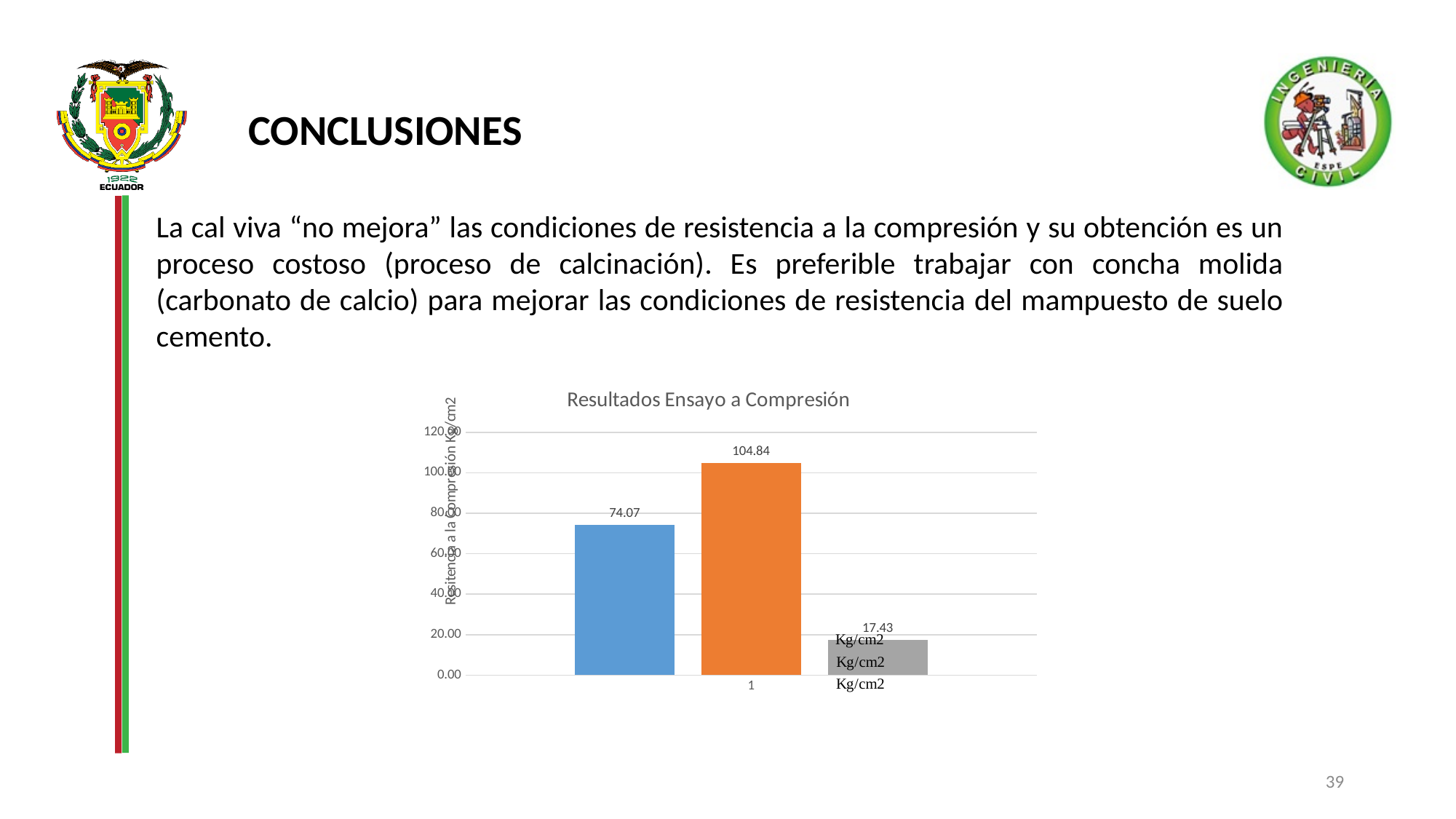
What is the difference between the blue bar and the gray bar values? 56.64 What is the value shown on the orange bar in the chart? 104.84 What is the value shown on the blue bar in the chart? 74.07 Which bar has the highest value in the chart? The orange bar (104.84) What kind of chart is shown on the slide? Bar chart Which bar has the lowest value in the chart? The gray bar (17.43) What is the value shown on the gray bar in the chart? 17.43 What is the title of the chart? Resultados Ensayo a Compresión Is the value of the orange bar greater or less than 100.00? greater Which is larger, the value of the blue bar or the value of the gray bar? The blue bar How many bars are plotted in the chart? 3 What is the difference between the orange bar and the blue bar values? 30.77